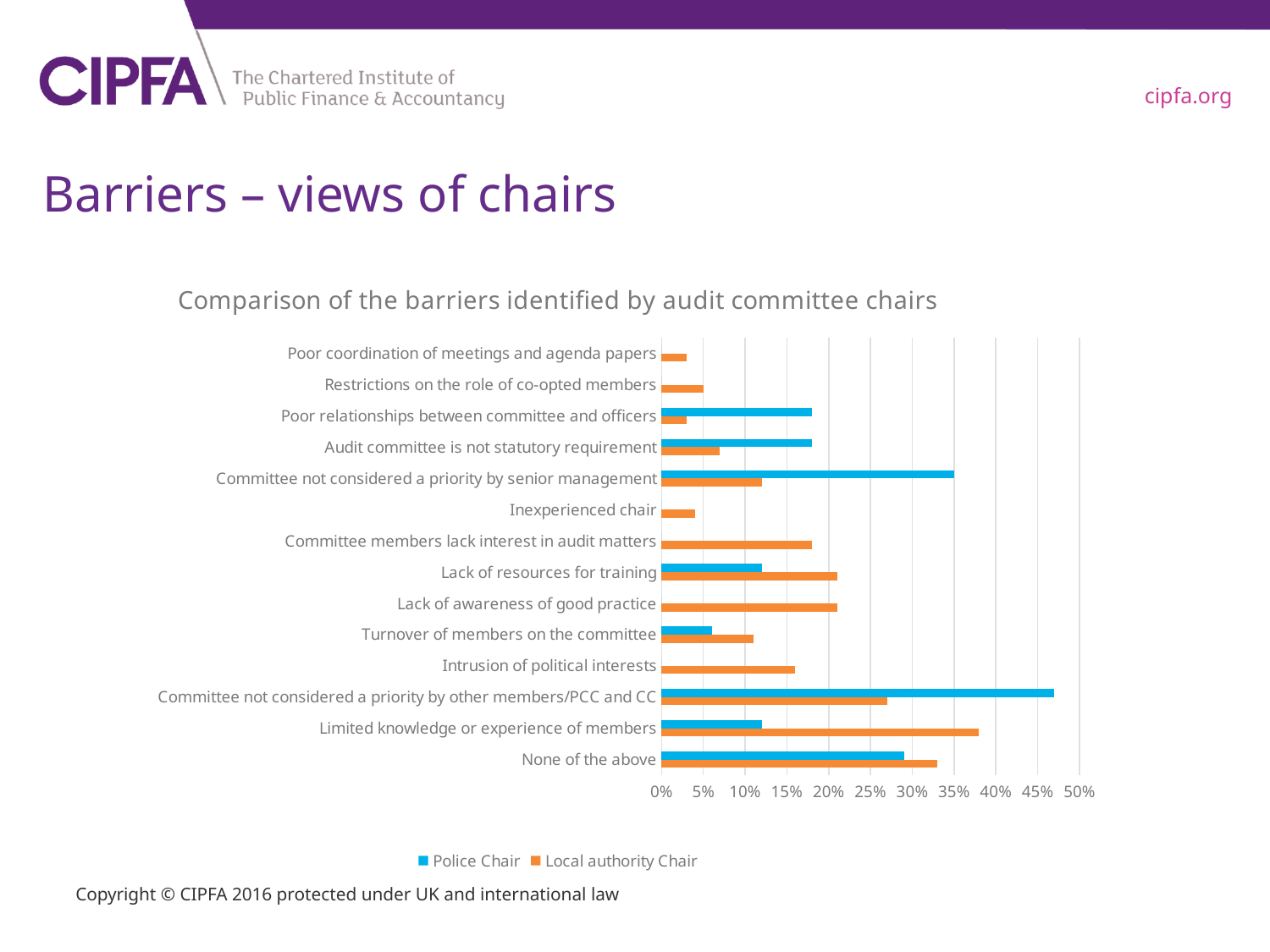
Which barrier has the highest value for Local authority Chair? Limited knowledge or experience of members How many barrier categories are plotted on the chart? 14 For 'Limited knowledge or experience of members', which series has the larger value: Police Chair or Local authority Chair? Local authority Chair What kind of chart is shown on the slide? Bar chart Is the Police Chair value for 'Committee not considered a priority by other members/PCC and CC' greater or less than 45%? greater How many series does the legend list? 2 For 'Committee not considered a priority by senior management', which series has the larger value: Police Chair or Local authority Chair? Police Chair Which barrier has the highest value for Police Chair? Committee not considered a priority by other members/PCC and CC Is the Local authority Chair value for 'Limited knowledge or experience of members' greater or less than 35%? greater Is the Local authority Chair value for 'Intrusion of political interests' greater or less than 20%? less What is the title of the chart? Comparison of the barriers identified by audit committee chairs